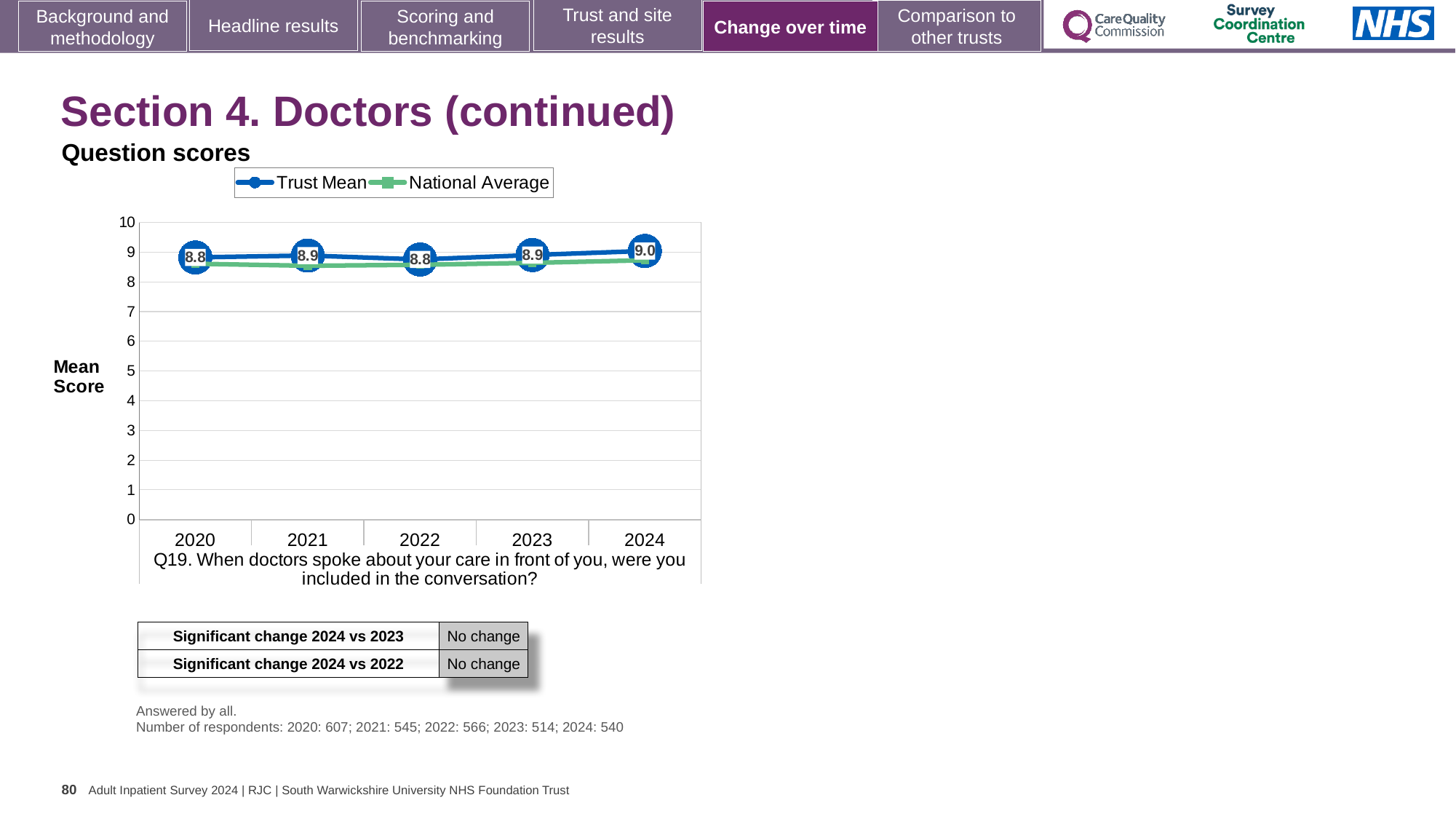
What is the Trust Mean score for 2020? 8.8 What is the Trust Mean score for 2022? 8.8 What is the difference between the Trust Mean score in 2024 and in 2020? 0.2 Is the National Average value for 2024 greater or less than 8? greater What is the Trust Mean score for 2024? 9.0 Does the Trust Mean score rise or fall from 2023 to 2024? Rise How many series does the legend list? 2 Is the National Average value for 2020 greater or less than 9? less What kind of chart is shown on the slide? Line chart How many years are shown on the x axis? 5 In which year is the Trust Mean score highest? 2024 Which is larger, the Trust Mean score in 2024 or in 2023? 2024